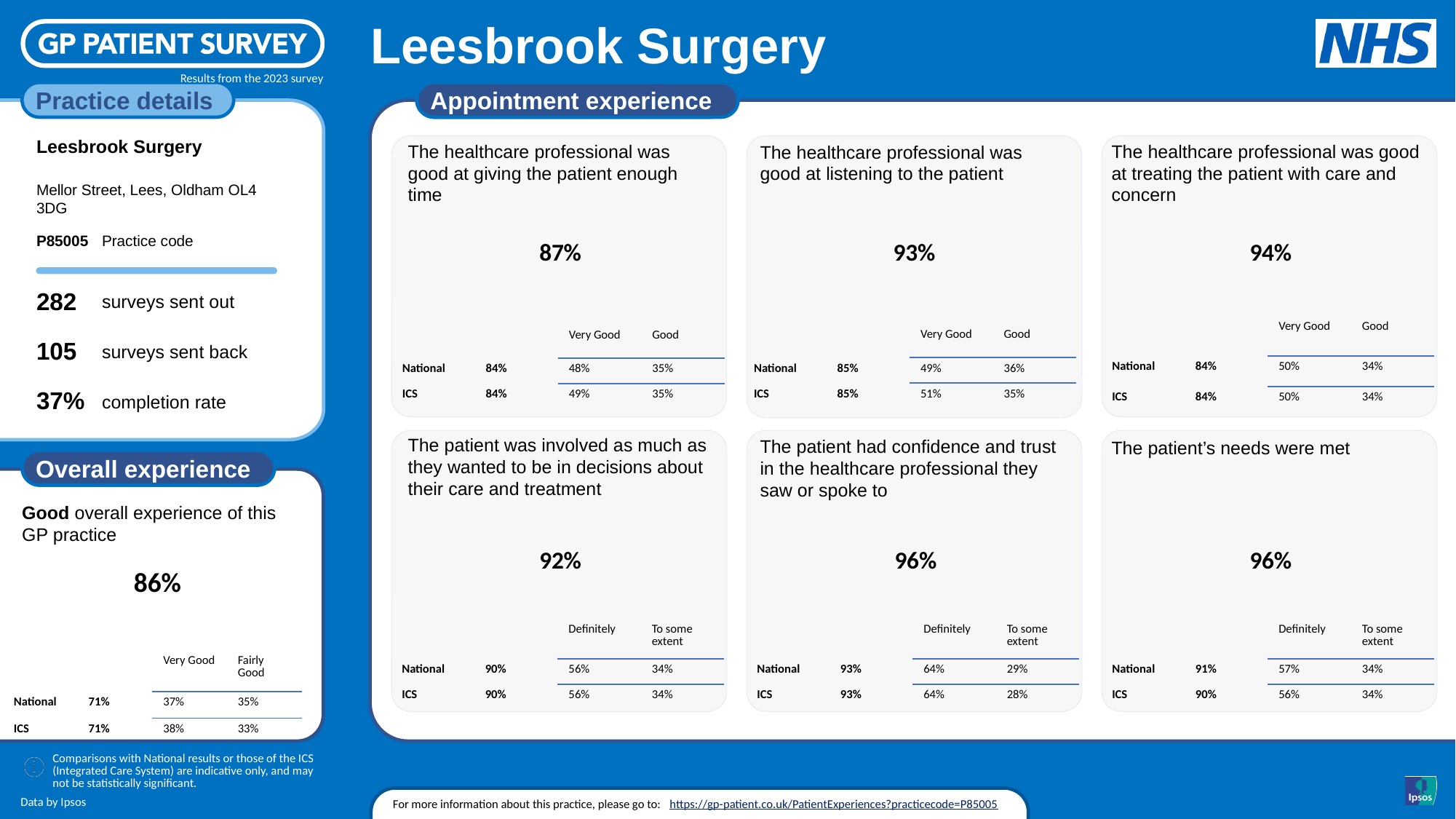
On the panel 'The patient was involved as much as they wanted to be in decisions about their care and treatment', what is the practice's headline percentage? 92% On the panel 'The patient's needs were met', what is the National figure? 91% On the 'Overall experience' panel, what percentage of patients reported a good overall experience of this GP practice? 86% On the panel 'The healthcare professional was good at giving the patient enough time', what is the practice's headline percentage? 87% On the panel 'The patient had confidence and trust in the healthcare professional they saw or spoke to', what is the ICS 'To some extent' percentage? 28% On the panel 'The healthcare professional was good at treating the patient with care and concern', what is the ICS figure? 84% On the 'Overall experience' panel, what is the difference between the practice's 86% and the National 71%? 15% On the 'Overall experience' panel, what is the National figure for good overall experience? 71% Which of the six 'Appointment experience' panels shows the lowest practice headline percentage? The healthcare professional was good at giving the patient enough time On the panel 'The healthcare professional was good at listening to the patient', is the practice's 93% higher or lower than the National 85%? higher On the panel 'The healthcare professional was good at listening to the patient', what is the National 'Good' percentage? 36% On the 'Overall experience' panel, what is the ICS 'Very Good' percentage? 38%